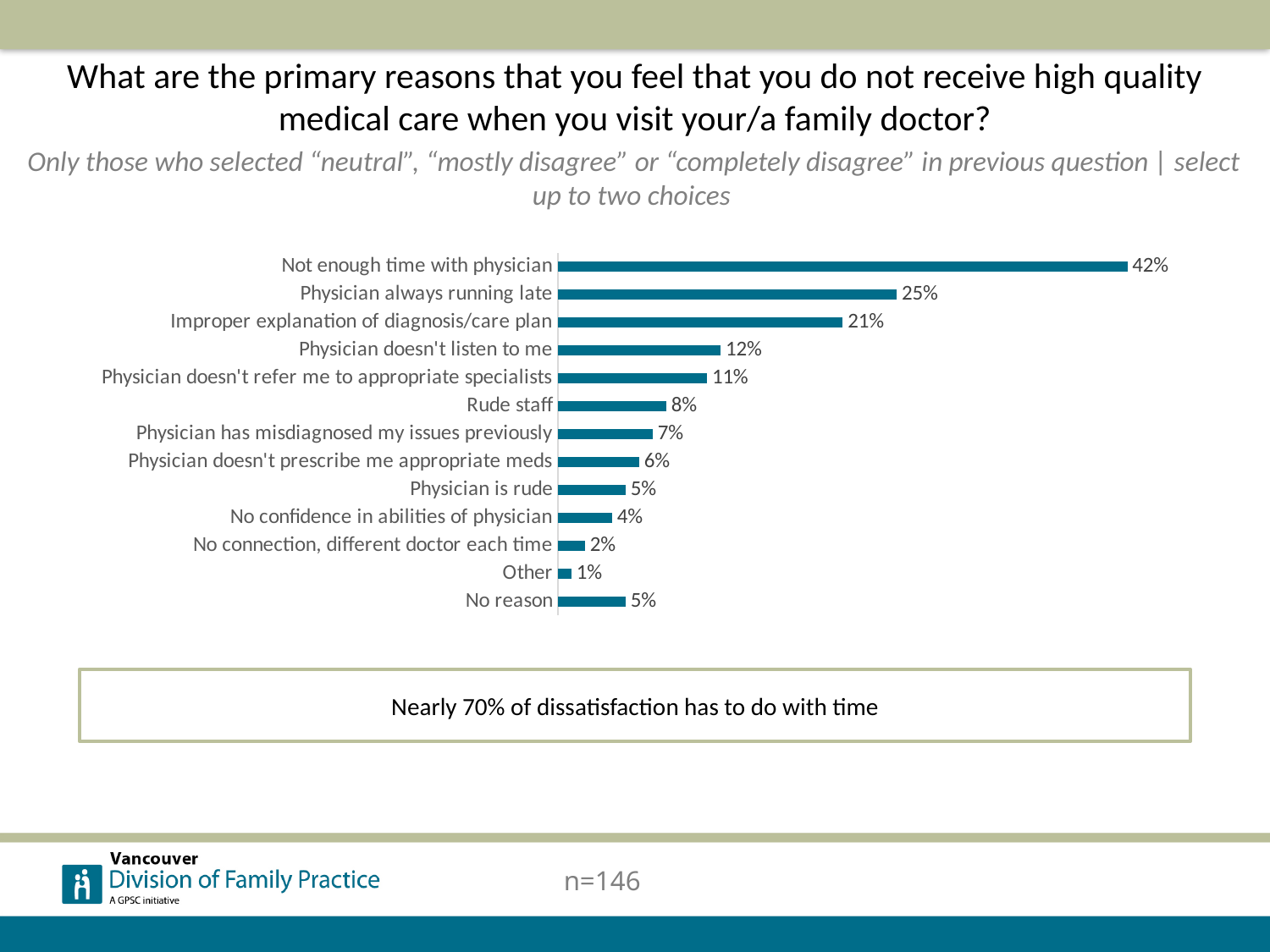
What is the difference between "Not enough time with physician" and "Physician always running late"? 17 percentage points What kind of chart is shown on the slide? Bar chart What is the sample size (n) shown on the slide? n=146 Which is larger: "Physician doesn't listen to me" or "Physician doesn't refer me to appropriate specialists"? Physician doesn't listen to me What percentage of respondents selected "Not enough time with physician"? 42% Which reason has the highest percentage? Not enough time with physician How many categories are shown in the chart? 13 What is the difference between "Improper explanation of diagnosis/care plan" and "Physician doesn't listen to me"? 9 percentage points Which category has the lowest percentage? Other What is the value for "Physician always running late"? 25% What percentage is shown for "Rude staff"? 8% What is the value for "No connection, different doctor each time"? 2%